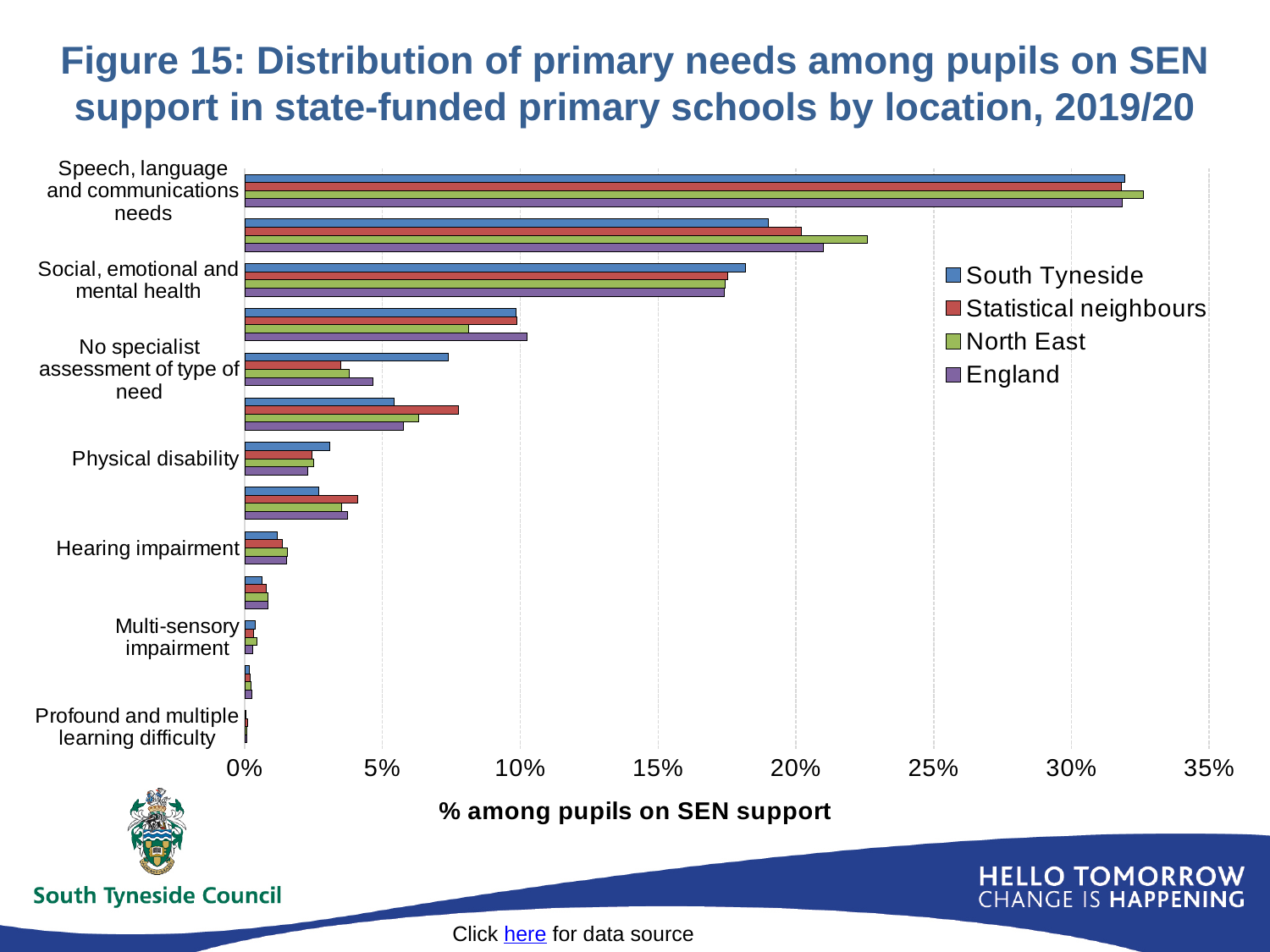
Do the percentages generally rise or fall moving down the list of primary needs from top to bottom? Fall For No specialist assessment of type of need, which is larger: the South Tyneside value or the England value? South Tyneside What is the label on the horizontal axis? % among pupils on SEN support Which series are listed in the legend? South Tyneside, Statistical neighbours, North East, England Is the England value for Physical disability greater or less than 5%? less Is the South Tyneside value for No specialist assessment of type of need greater or less than 5%? greater Is the South Tyneside value for Speech, language and communications needs greater or less than 30%? greater How many series does the legend list? 4 Which labelled primary need has the lowest percentages across all locations? Profound and multiple learning difficulty What kind of chart is shown on the slide? Bar chart Which primary need has the highest percentages across all locations? Speech, language and communications needs